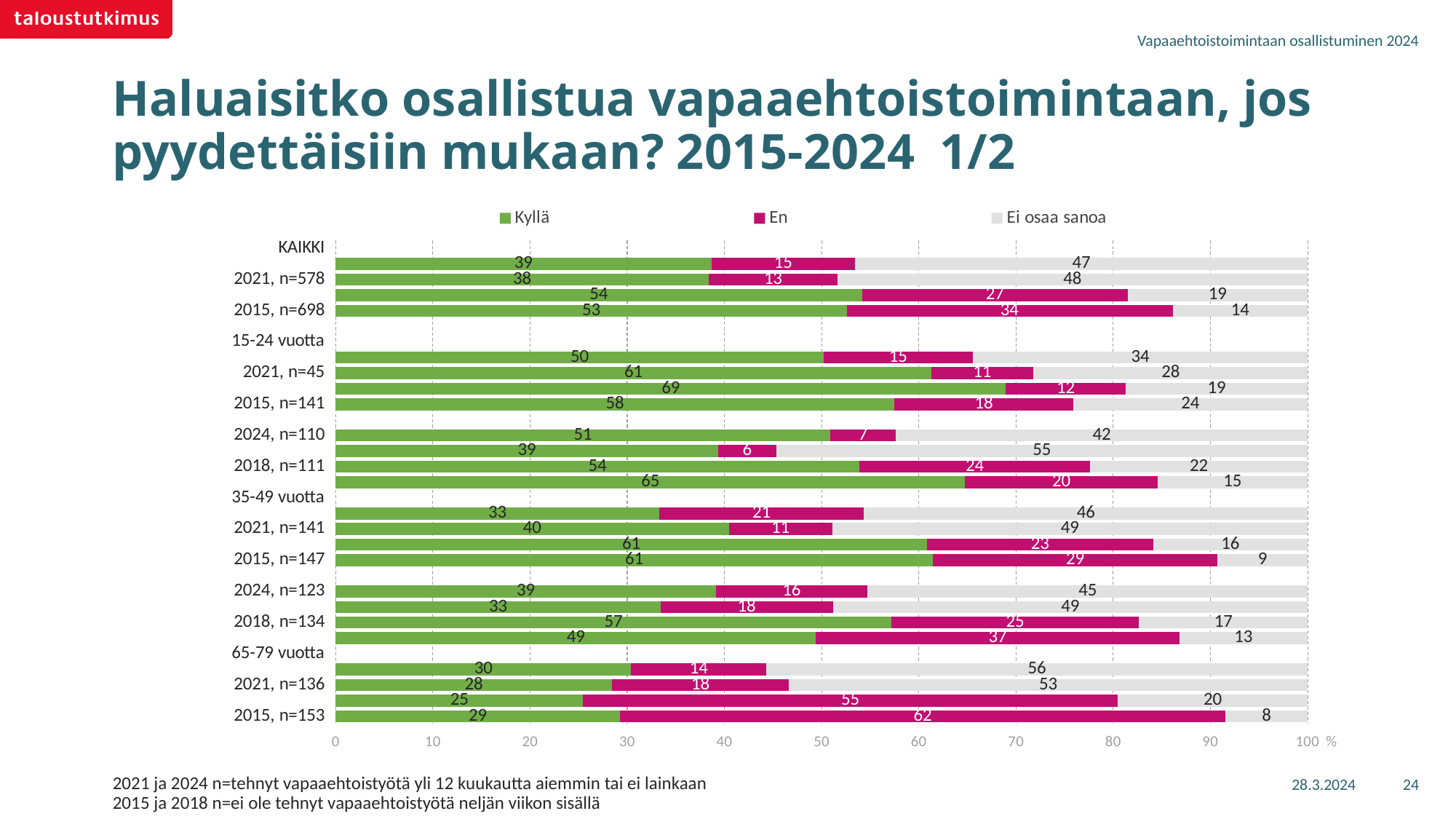
What is the Kyllä value for the row labelled 2015, n=698? 53 What is the Kyllä value for the row labelled 2018, n=134? 57 How many series does the legend list? 3 What is the Ei osaa sanoa value for the row labelled 2021, n=136? 53 What kind of chart is shown on the slide? Stacked bar chart What is the En value for the row labelled 2015, n=153? 62 What are the three legend entries of the chart? Kyllä, En, Ei osaa sanoa What is the difference between the En value for 2015, n=698 and the En value for 2021, n=578? 21 What is the Ei osaa sanoa value for the row labelled 2015, n=147? 9 Which row has the larger Kyllä value: 2021, n=45 or 2021, n=136? 2021, n=45 What is the total of the three segments in the bar for 2024, n=110? 100 Which row has the highest En value? 2015, n=153